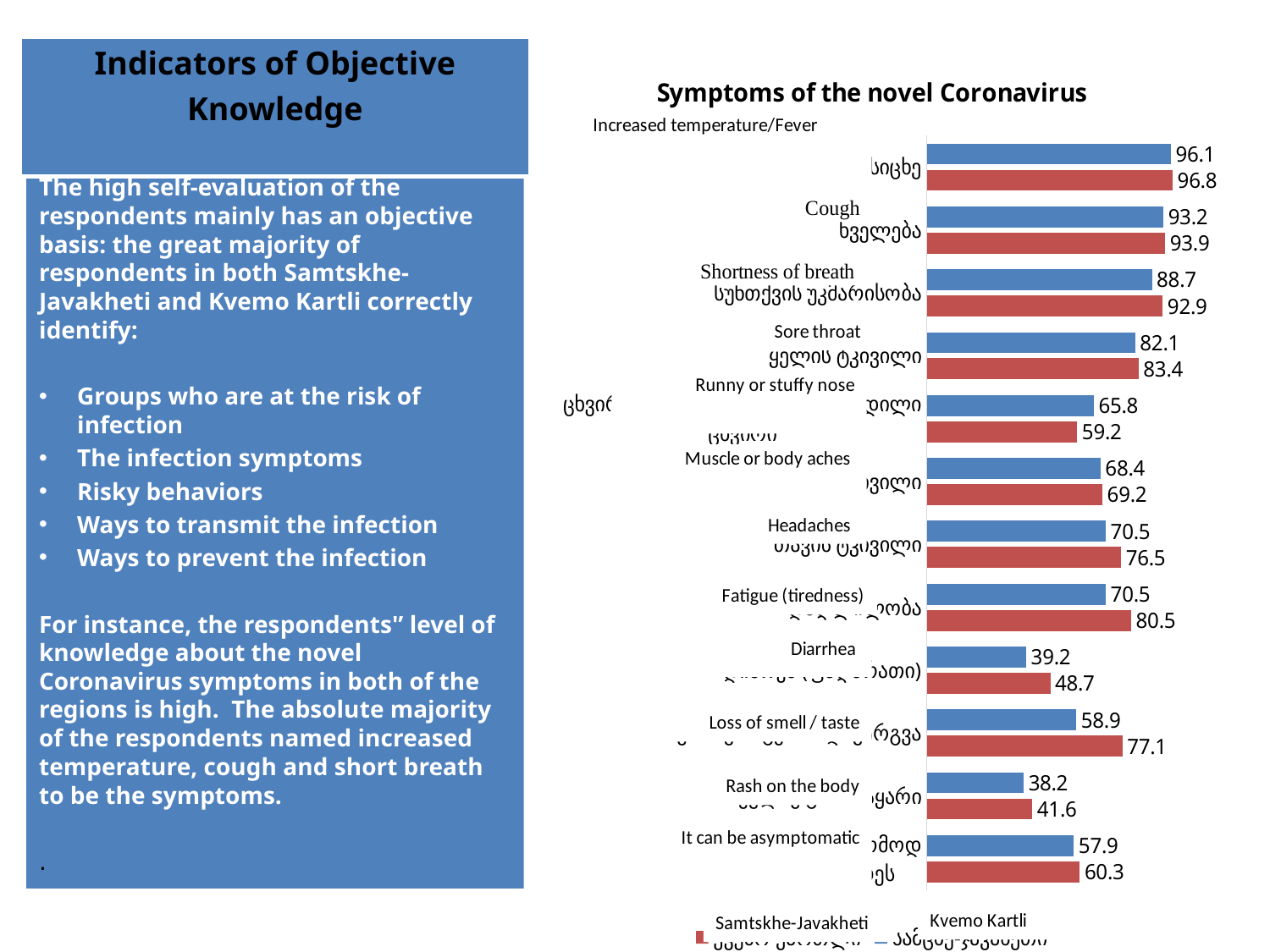
What is the difference between the red bar and the blue bar for Loss of smell / taste? 18.2 Which symptom has the lowest value for the blue bars? Rash on the body How many series does the chart's legend list? 2 For Runny or stuffy nose, which bar is larger, the blue bar or the red bar? the blue bar Which symptom has the highest value for the red bars? Increased temperature/Fever How many symptom categories are shown in the chart? 12 What is the title of the chart on the right side of the slide? Symptoms of the novel Coronavirus What is the value of the red bar for Diarrhea? 48.7 What type of chart is used to show the symptoms of the novel Coronavirus? bar chart What is the value of the red bar for Loss of smell / taste? 77.1 What is the difference between the red bar and the blue bar for Fatigue (tiredness)? 10.0 What is the value of the blue bar for Increased temperature/Fever? 96.1